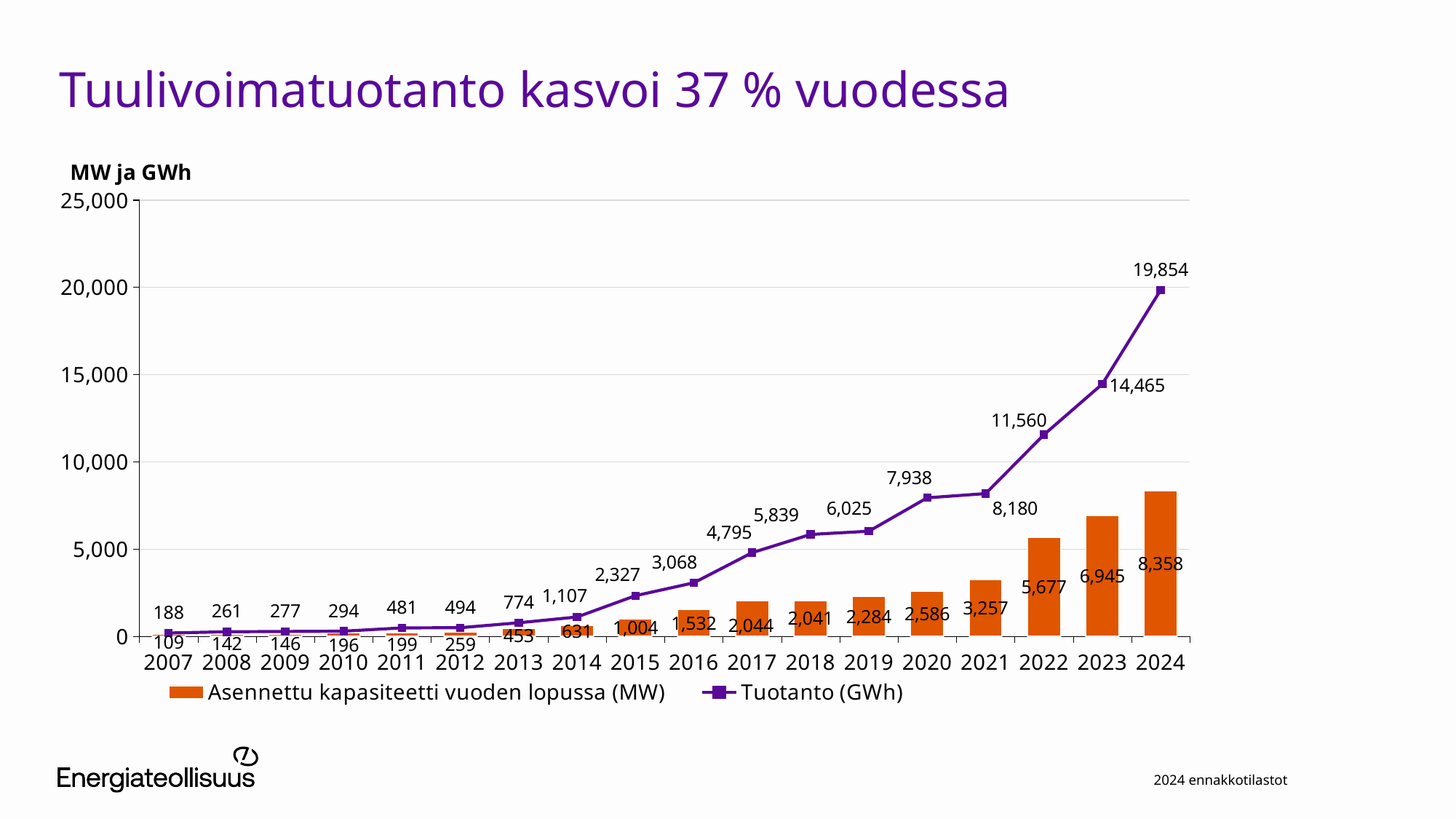
Which is larger: Asennettu kapasiteetti vuoden lopussa (MW) in 2017 or in 2018? 2017 What kind of chart is shown on the slide? Combined bar and line chart By how much did Tuotanto (GWh) increase from 2023 to 2024? 5,389 How many series does the legend list? 2 What is the title of the slide? Tuulivoimatuotanto kasvoi 37 % vuodessa What was the Tuotanto (GWh) value in 2015? 2,327 How many years are shown on the x axis? 18 What was the Asennettu kapasiteetti vuoden lopussa (MW) in 2022? 5,677 In which year was Asennettu kapasiteetti vuoden lopussa (MW) lowest? 2007 What was the Tuotanto (GWh) value in 2024? 19,854 Is the Tuotanto (GWh) value for 2022 greater or less than 10,000? greater In which year was Tuotanto (GWh) highest? 2024